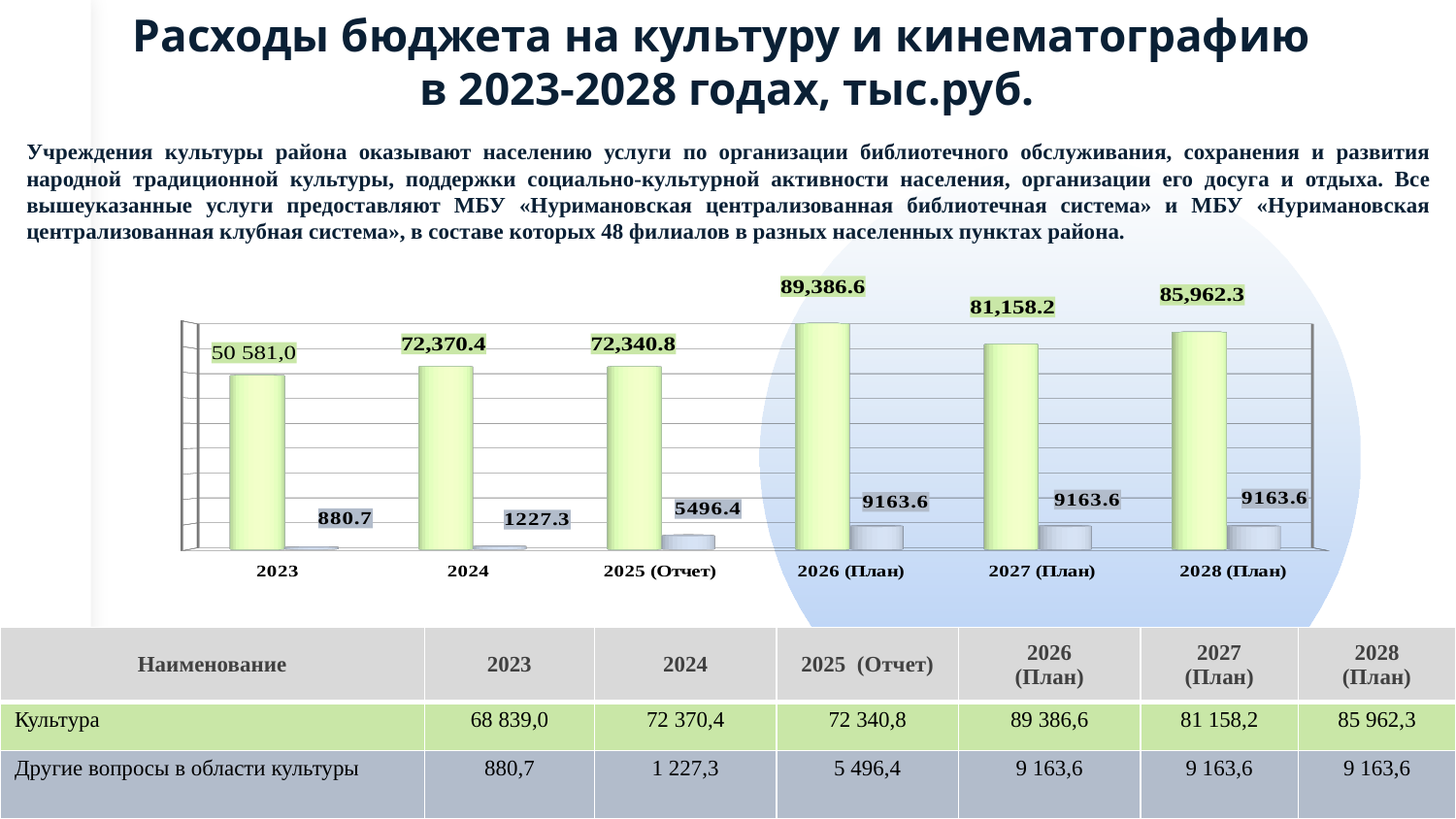
Do the grey bar values rise or fall from 2023 to 2026 (План)? rise What unit of measurement is stated in the slide title for the chart values? тыс.руб. What is the value of the tall green bar for 2026 (План)? 89,386.6 What is the difference between the grey bar values for 2025 (Отчет) and 2024? 4269.1 Which green bar is larger, 2027 (План) or 2028 (План)? 2028 (План) What is the value of the small grey bar for 2025 (Отчет)? 5496.4 What kind of chart is shown on the slide? bar chart What is the difference between the green bar values for 2026 (План) and 2027 (План)? 8,228.4 In which year is the tall green bar the highest? 2026 (План) What is the value of the small grey bar for 2028 (План)? 9163.6 In which year is the small grey bar the lowest? 2023 How many year categories are shown along the x axis of the chart? 6